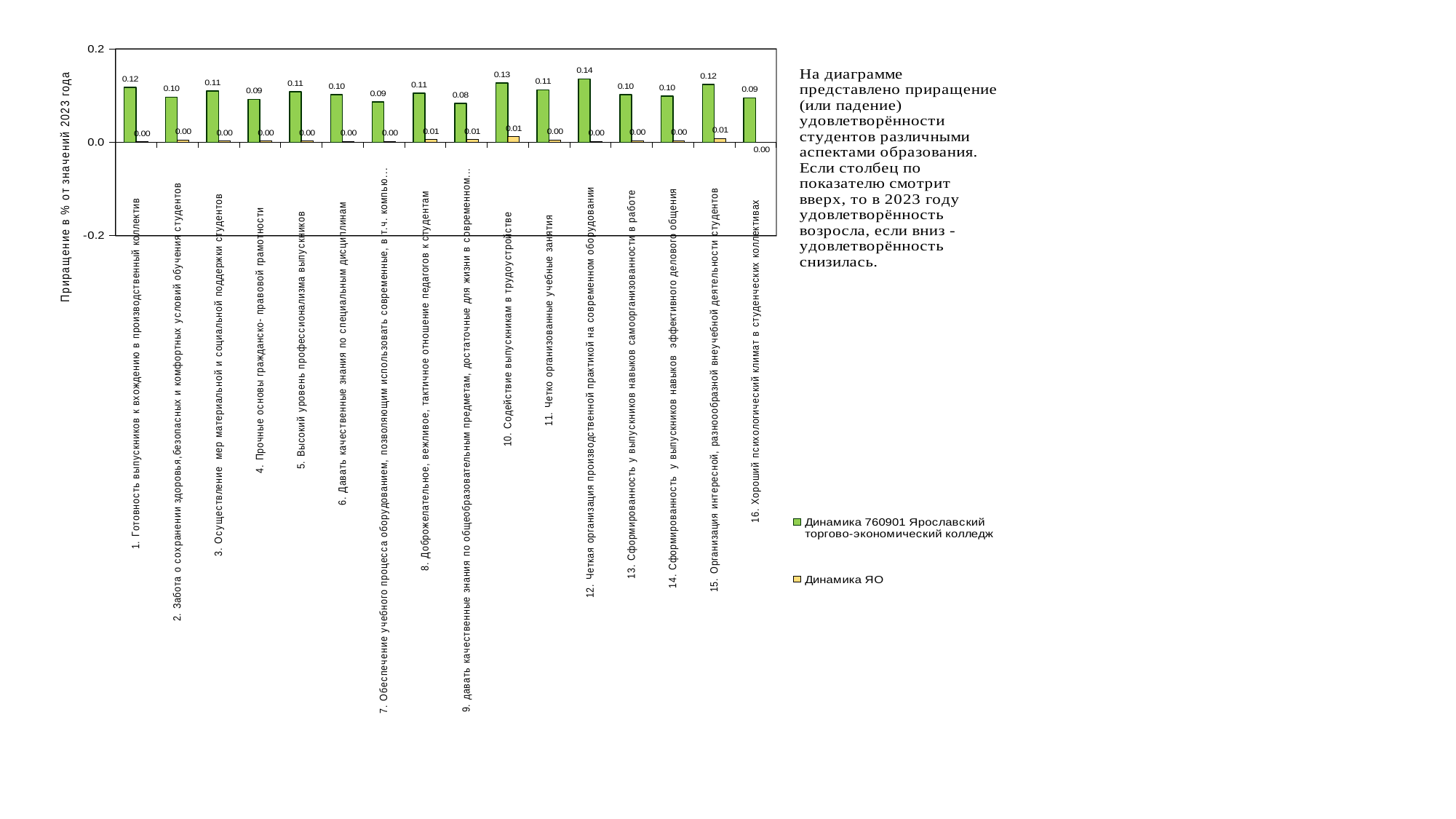
For the series "Динамика 760901 Ярославский торгово-экономический колледж", which is larger: the value for "15. Организация интересной, разнообразной внеучебной деятельности студентов" or for "13. Сформированность у выпускников навыков самоорганизованности в работе"? 15. Организация интересной, разнообразной внеучебной деятельности студентов For "12. Четкая организация производственной практикой на современном оборудовании", what is the difference between the college series value and the "Динамика ЯО" value? 0.14 How many series does the legend list? 2 What is the value of the series "Динамика ЯО" for "10. Содействие выпускникам в трудоустройстве"? 0.01 What kind of chart is shown on the slide? bar chart For the series "Динамика 760901 Ярославский торгово-экономический колледж", what is the difference between the value for category 1 (Готовность выпускников к вхождению в производственный коллектив) and category 16 (Хороший психологический климат в студенческих коллективах)? 0.03 What is the title of the vertical axis of the chart? Приращение в % от значений 2023 года What is the value of the series "Динамика 760901 Ярославский торгово-экономический колледж" for "1. Готовность выпускников к вхождению в производственный коллектив"? 0.12 What is the value of the series "Динамика 760901 Ярославский торгово-экономический колледж" for "10. Содействие выпускникам в трудоустройстве"? 0.13 How many categories are plotted along the x axis? 16 Which category has the highest value for the series "Динамика 760901 Ярославский торгово-экономический колледж"? 12. Четкая организация производственной практикой на современном оборудовании What is the value of the series "Динамика 760901 Ярославский торгово-экономический колледж" for "16. Хороший психологический климат в студенческих коллективах"? 0.09